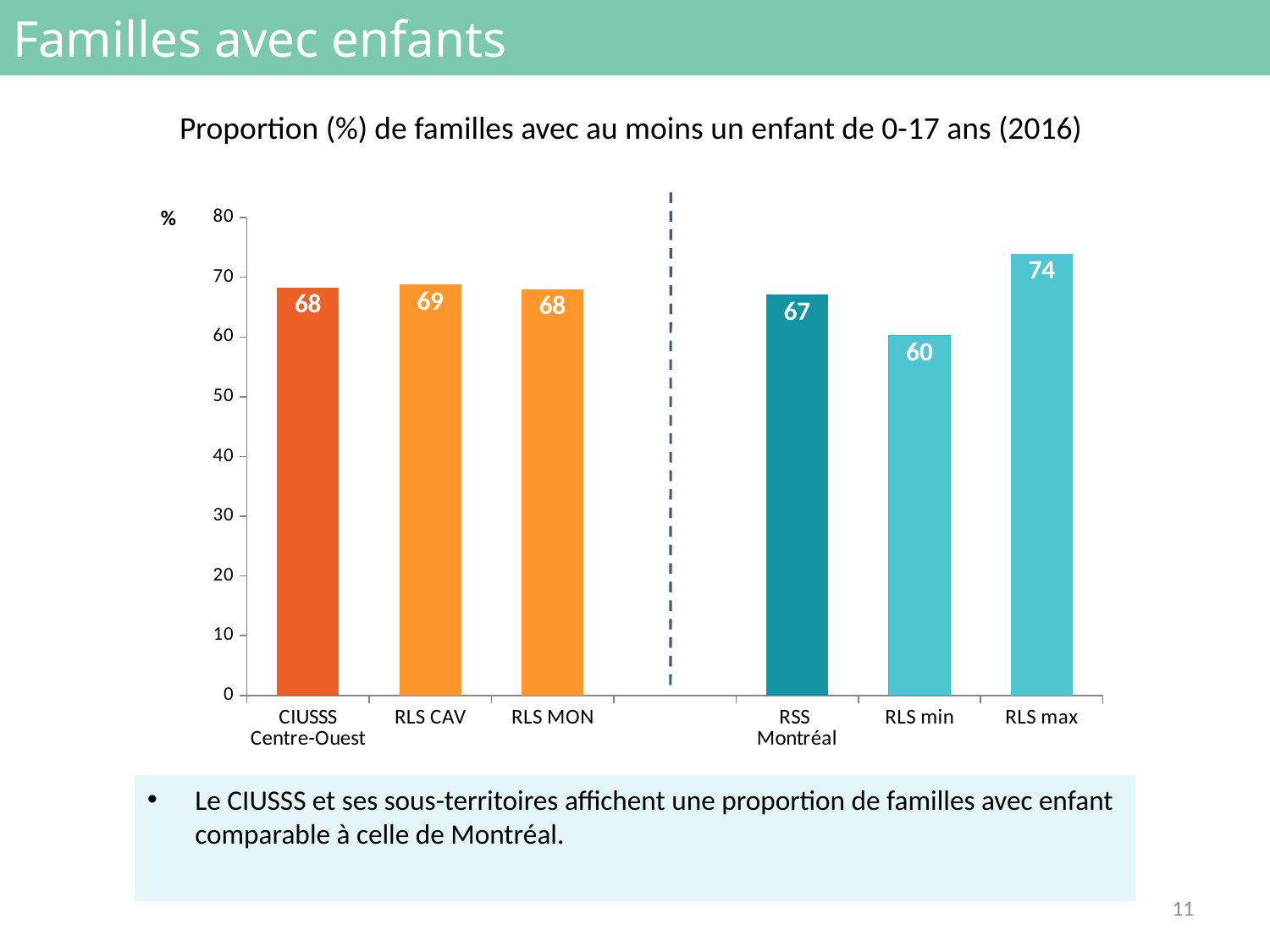
Which category has the highest value? RLS max Which is larger, the value for RLS MON or the value for RLS min? RLS MON Which category has the lowest value? RLS min What is the title of the chart? Proportion (%) de familles avec au moins un enfant de 0-17 ans (2016) What kind of chart is shown on the slide? Bar chart What is the value for RSS Montréal? 67 What is the value for RLS CAV? 69 What is the difference between the values for RLS CAV and RSS Montréal? 2 What is the value for RLS min? 60 What is the value for CIUSSS Centre-Ouest? 68 How many bars are shown in the chart? 6 What is the difference between the values for RLS max and RLS min? 14